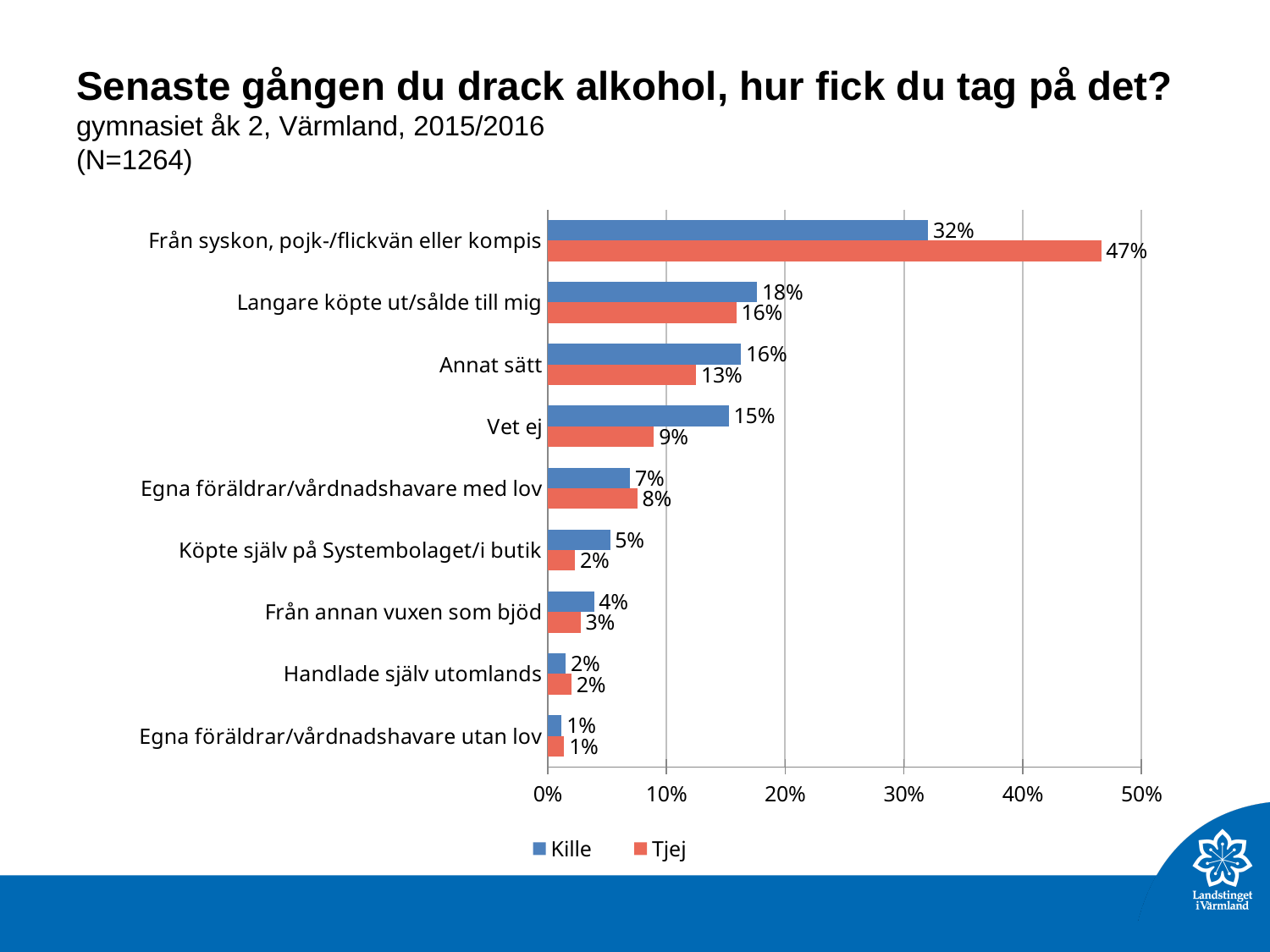
How many series does the legend list? 2 What kind of chart is shown on the slide? Bar chart What is the value for Tjej for "Från syskon, pojk-/flickvän eller kompis"? 47% Which category has the lowest value for Tjej? Egna föräldrar/vårdnadshavare utan lov What is the value for Tjej for "Annat sätt"? 13% What is the difference between the Tjej and Kille values for "Från syskon, pojk-/flickvän eller kompis"? 15% What is the sample size (N) stated in the slide subtitle? N=1264 What is the value for Kille for "Vet ej"? 15% How many categories are shown on the chart? 9 Which category has the highest value for Kille? Från syskon, pojk-/flickvän eller kompis Which is larger for "Egna föräldrar/vårdnadshavare med lov": Kille or Tjej? Tjej Which is larger for "Langare köpte ut/sålde till mig": Kille or Tjej? Kille